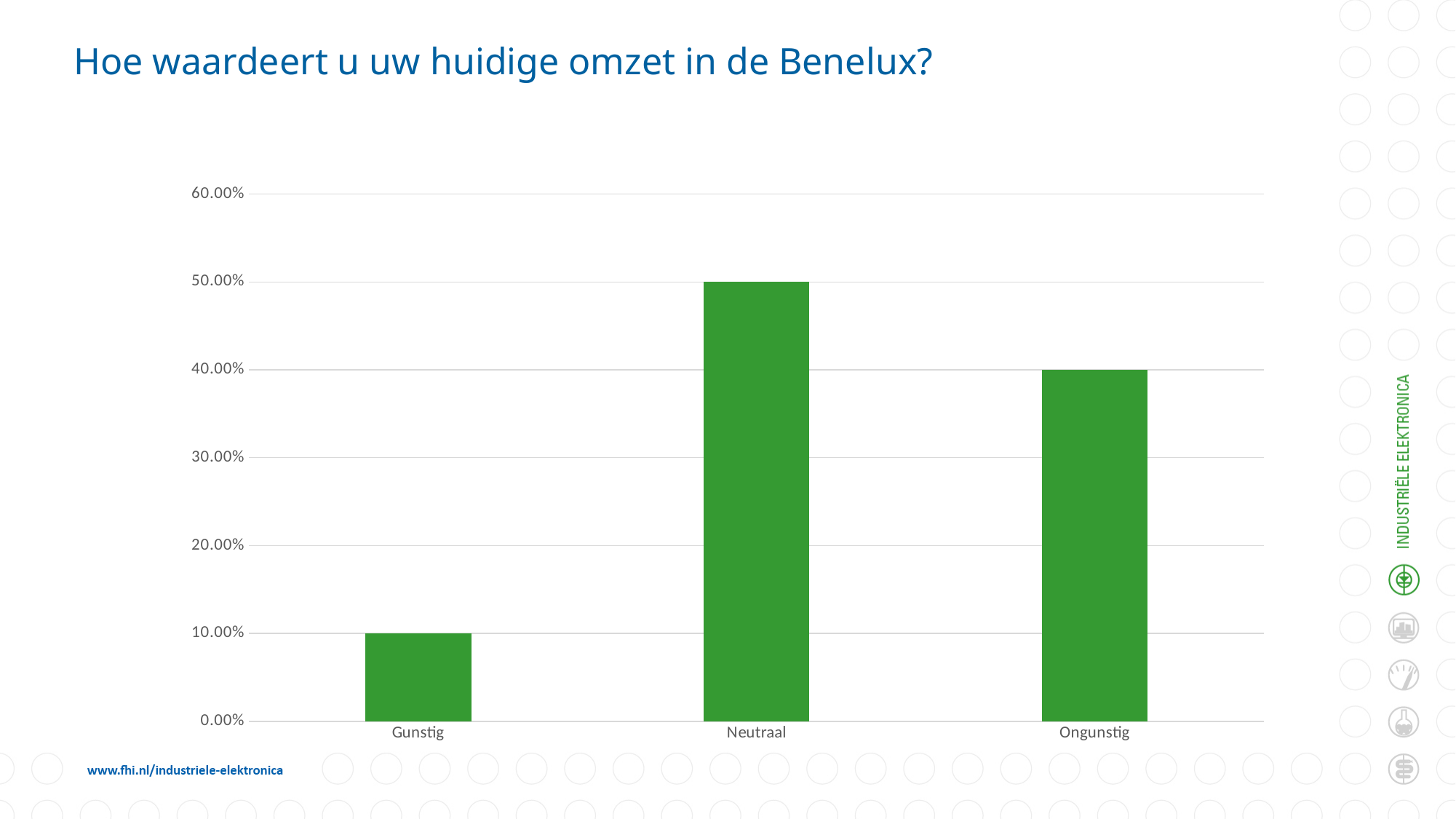
Which is larger, the value for Gunstig or the value for Ongunstig? Ongunstig What is the value for Gunstig? 10.00% What is the difference between the values for Neutraal and Ongunstig? 10.00% What is the title of the slide? Hoe waardeert u uw huidige omzet in de Benelux? Is the value for Neutraal greater or less than 30.00%? greater How many categories are shown on the x axis? 3 What is the value for Neutraal? 50.00% What is the value for Ongunstig? 40.00% What kind of chart is shown on the slide? bar chart Which category has the lowest value? Gunstig Which category has the highest value? Neutraal What is the difference between the values for Ongunstig and Gunstig? 30.00%